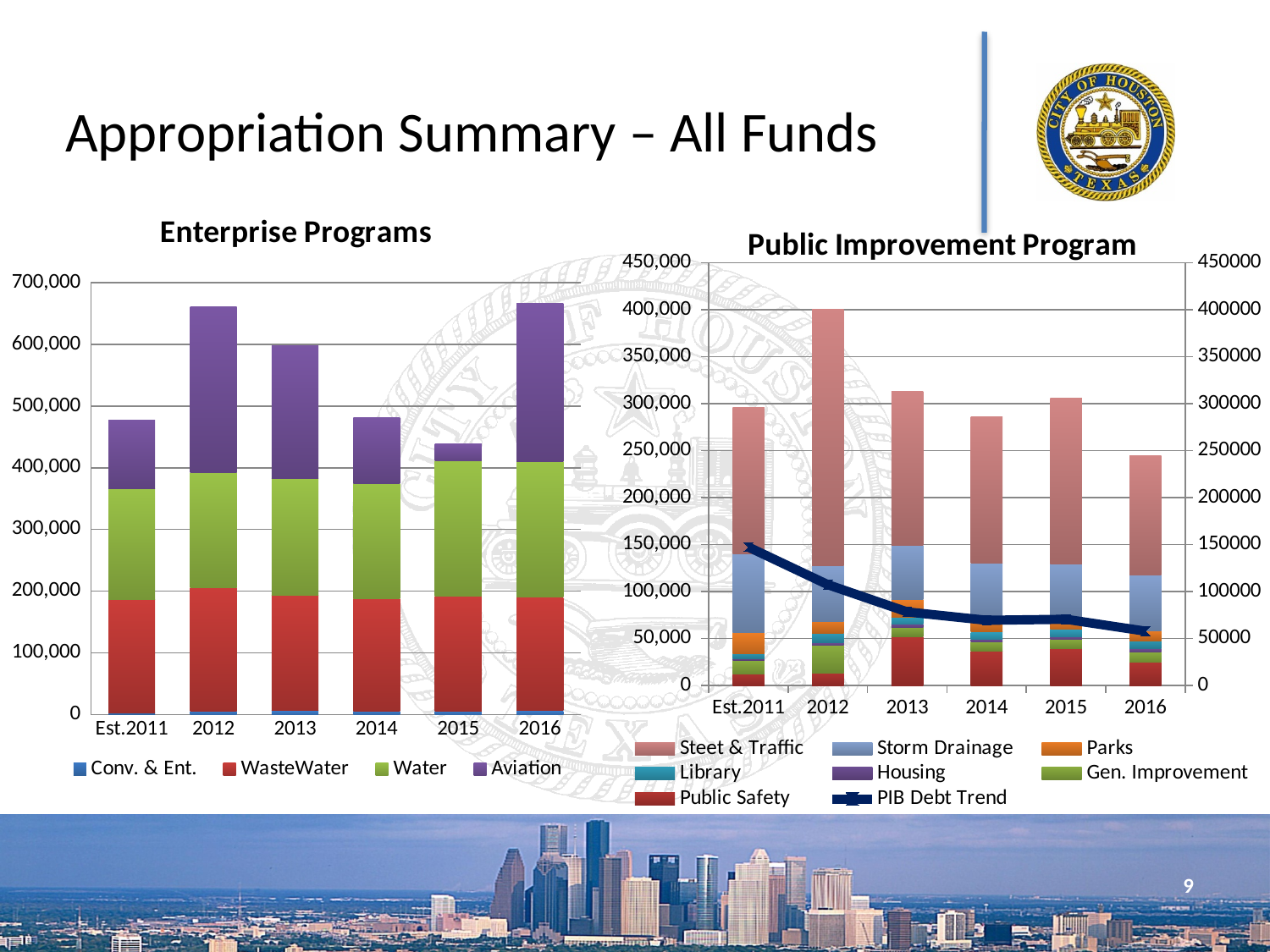
In the Enterprise Programs chart, which is larger, the total for 2012 or the total for 2014? 2012 In the Public Improvement Program chart, which year has the highest total bar? 2012 What kind of chart is the Enterprise Programs chart? stacked bar chart How many series does the legend of the Enterprise Programs chart list? 4 In the Enterprise Programs chart, which year has the lowest total bar? 2015 In the Public Improvement Program chart, does the PIB Debt Trend line rise or fall from Est.2011 to 2016? fall In the Public Improvement Program chart, is the total for 2012 greater or less than 350,000? greater In the Enterprise Programs chart, is the total for 2012 greater or less than 600,000? greater In the Enterprise Programs chart, is the total for 2015 greater or less than 500,000? less How many year categories are shown on the x axis of the Enterprise Programs chart? 6 In the Public Improvement Program chart, which year has the lowest total bar? 2016 How many entries does the legend of the Public Improvement Program chart list? 8